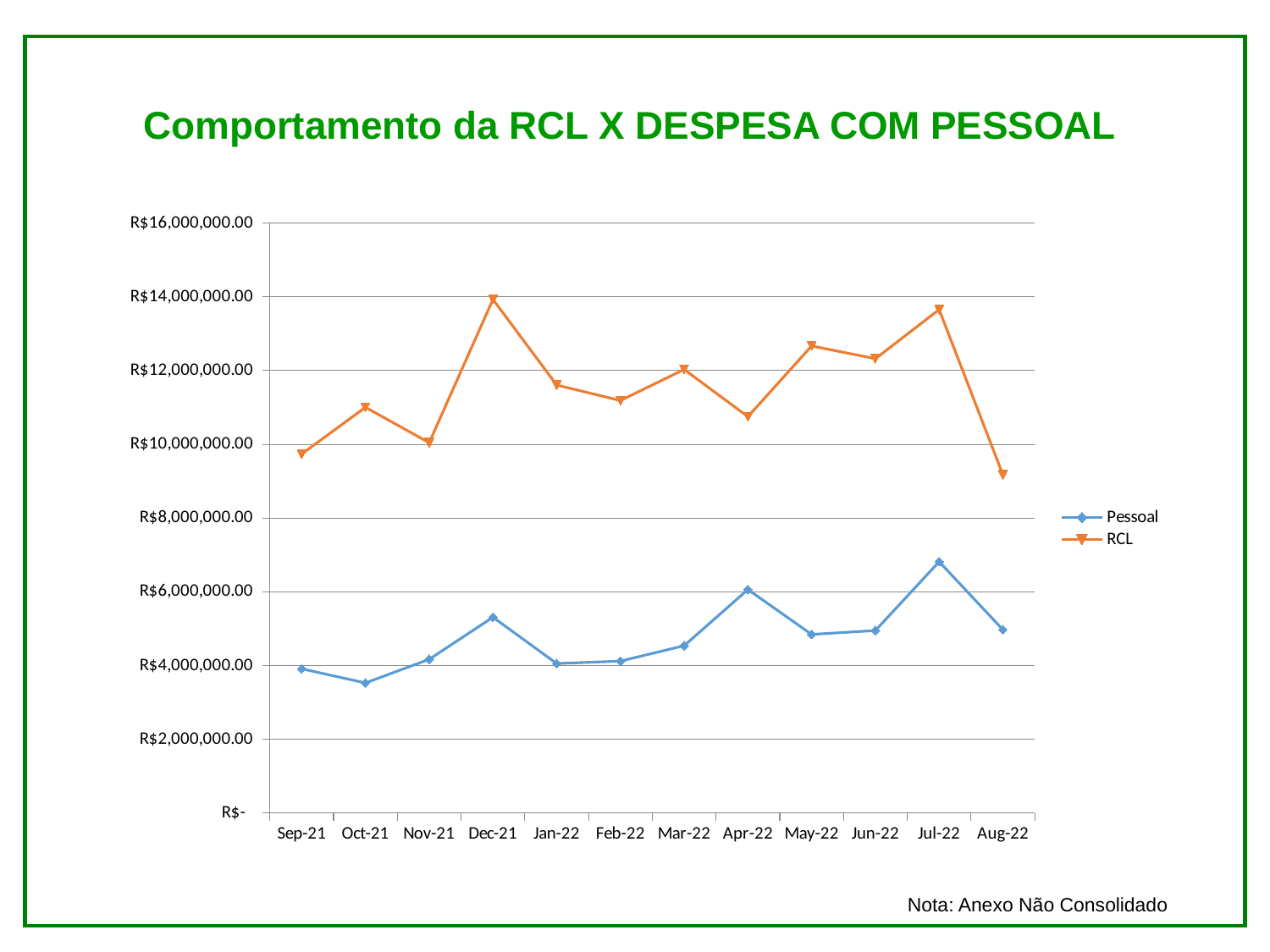
In which month does the Pessoal series reach its highest value? Jul-22 How many months are plotted along the x axis? 12 In which month does the Pessoal series reach its lowest value? Oct-21 What is the title of the chart? Comportamento da RCL X DESPESA COM PESSOAL Is the RCL value for Aug-22 greater or less than R$10,000,000.00? less Does the RCL series rise or fall from Jul-22 to Aug-22? Fall What kind of chart is shown on the slide? Line chart Is the Pessoal value for Jul-22 greater or less than R$6,000,000.00? greater In which month does the RCL series reach its lowest value? Aug-22 Which is larger in Apr-22, the RCL value or the Pessoal value? RCL Is the RCL value for Dec-21 greater or less than R$12,000,000.00? greater How many series does the legend list? 2